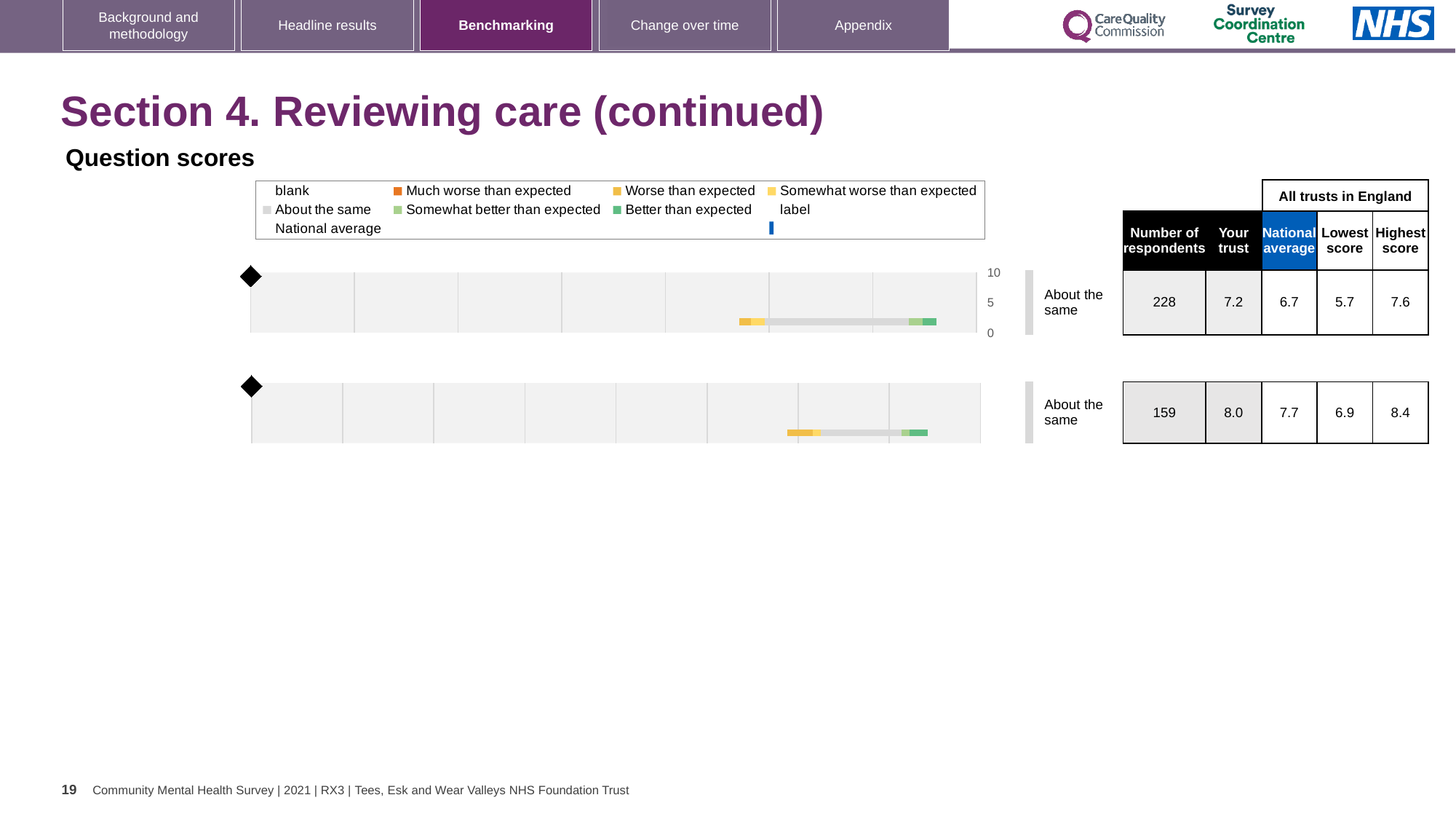
For the bottom chart's row, what is the difference between the highest score and the lowest score? 1.5 How many respondents are listed for the top chart's row? 228 What benchmark category is shown next to the top chart? About the same In the top chart's row of the table, what is the national average score? 6.7 For the bottom chart's row, which is larger: the 'Your trust' score or the national average? Your trust What is the lowest score among all trusts in England for the top chart's row? 5.7 For the top chart's row, what is the difference between the 'Your trust' score and the national average? 0.5 In the bottom chart's row of the table, what is the national average score? 7.7 In the top chart's row of the table, what is the 'Your trust' score? 7.2 In the bottom chart's row of the table, what is the 'Your trust' score? 8.0 What is the highest score among all trusts in England for the bottom chart's row? 8.4 Which row has more respondents, the top chart's row or the bottom chart's row? The top chart's row